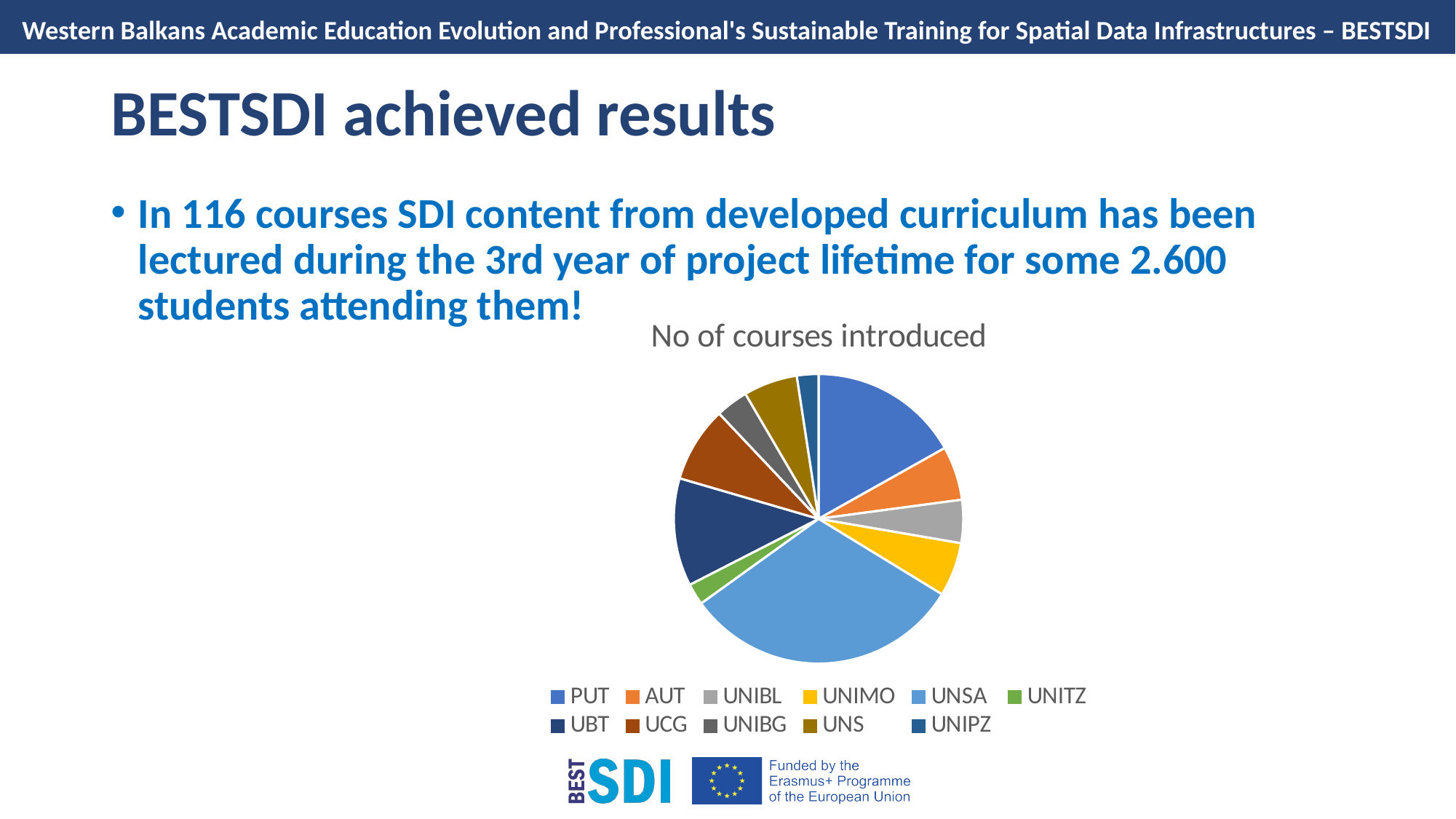
Which category has the largest slice of the pie? UNSA Which slice is larger, UBT or AUT? UBT What kind of chart is shown on the slide? pie chart How many categories does the pie chart's legend list? 11 Which slice is larger, UNSA or UBT? UNSA Which slice is larger, UCG or UNIBG? UCG What is the title of the chart? No of courses introduced What colour is the UNIMO slice in the pie chart? yellow